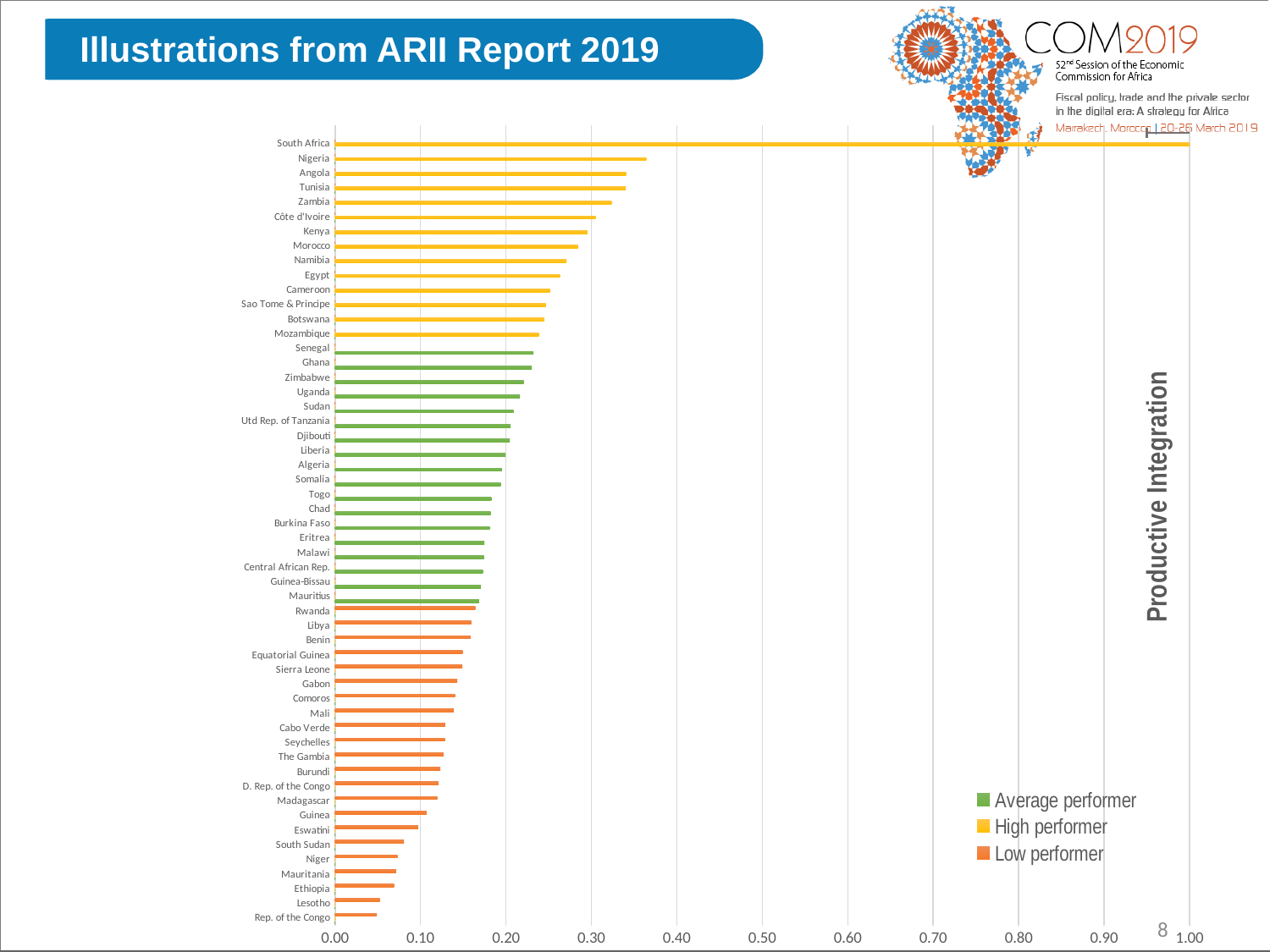
Is the value for South Sudan greater or less than 0.10? less Which has the larger value, Senegal or Libya? Senegal Is the value for Rwanda greater or less than 0.20? less What kind of chart is shown on the slide? bar chart How many series does the legend list? 3 Is the value for Nigeria greater or less than 0.30? greater What is the Productive Integration value for South Africa? 1.00 Which country has the highest Productive Integration value? South Africa How many countries are classified as High performer (yellow bars)? 14 What colour represents the Low performer category in the legend? orange Which has the larger value, Nigeria or Morocco? Nigeria